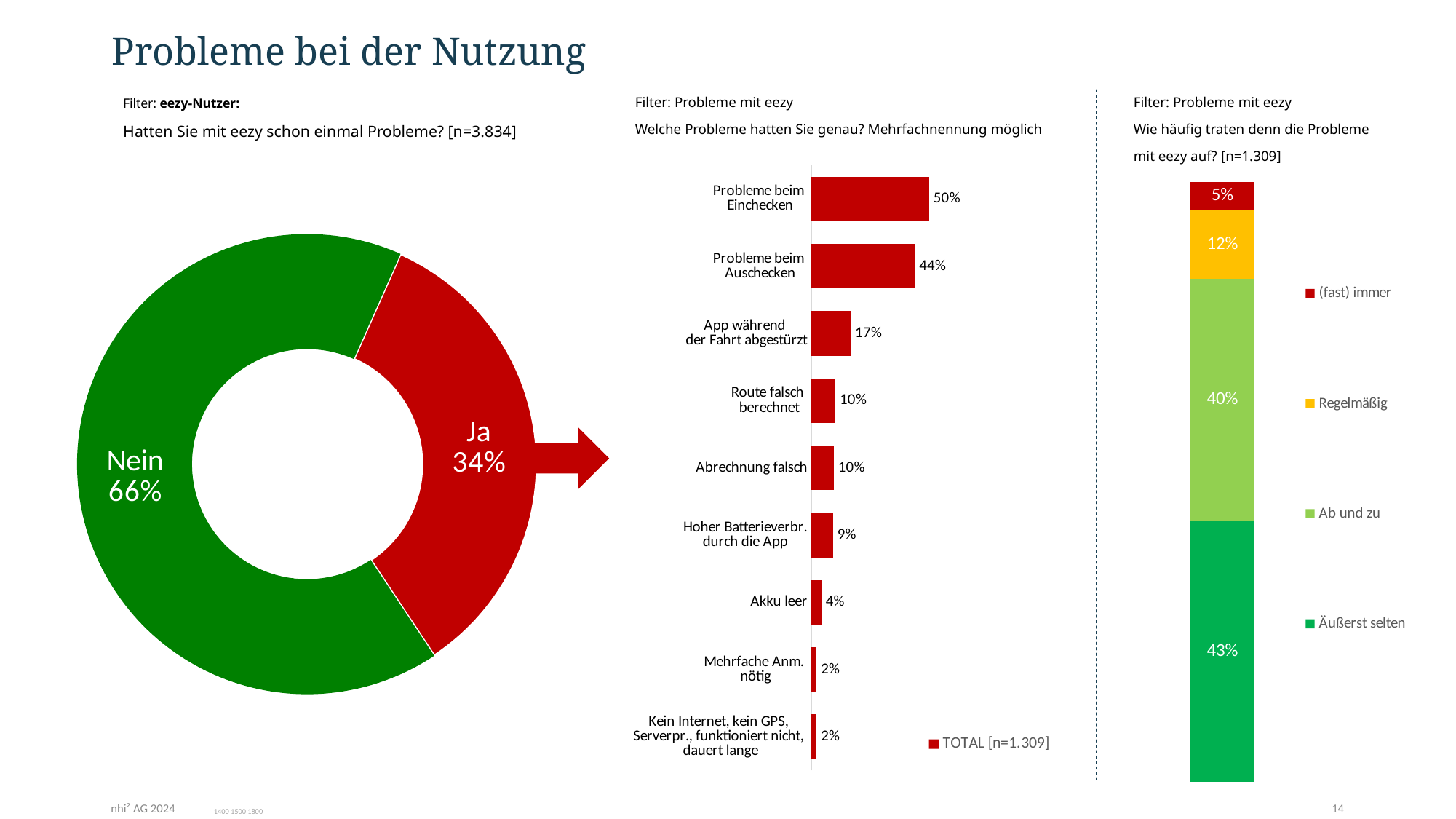
In the middle bar chart, which category has the highest value? Probleme beim Einchecken How many categories are shown in the middle bar chart? 9 In the middle bar chart, which is larger: 'Hoher Batterieverbr. durch die App' or 'Akku leer'? Hoher Batterieverbr. durch die App What kind of chart is the middle chart listing the problems? Bar chart In the right stacked bar chart (Wie häufig traten denn die Probleme mit eezy auf?), what is the value for 'Äußerst selten'? 43% In the left donut chart (Hatten Sie mit eezy schon einmal Probleme?), what share answered 'Nein'? 66% In the left donut chart, what share answered 'Ja'? 34% How many series does the legend of the right stacked bar chart list? 4 In the middle bar chart (Welche Probleme hatten Sie genau?), what is the value for 'Probleme beim Einchecken'? 50% What kind of chart is the left chart showing 'Nein' and 'Ja'? Donut (pie) chart In the middle bar chart, what is the value for 'App während der Fahrt abgestürzt'? 17% In the middle bar chart, what is the difference between 'Probleme beim Einchecken' and 'Probleme beim Auschecken'? 6 percentage points